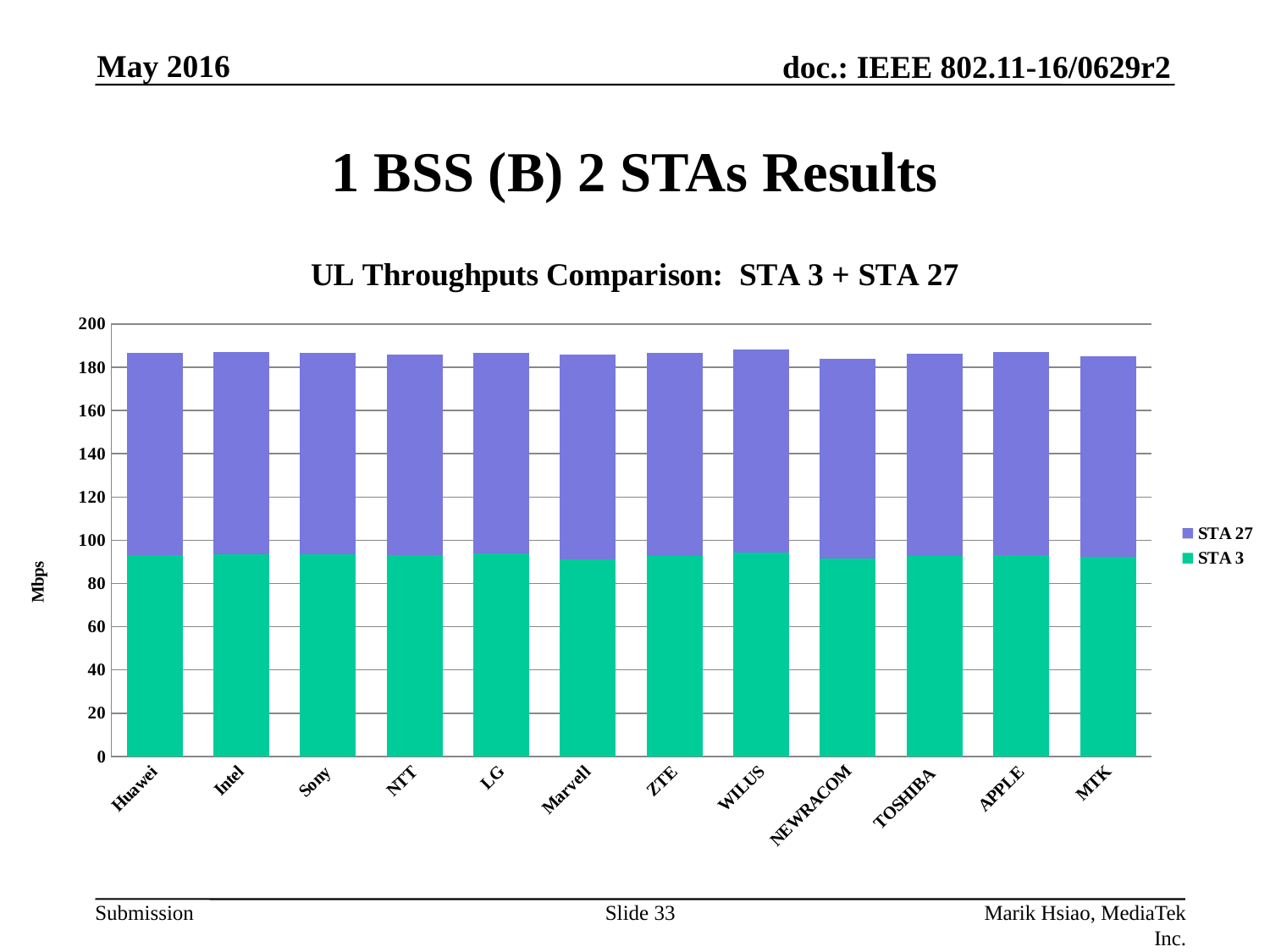
How many series does the legend list? 2 How many companies are shown along the x axis of the chart? 12 Is the total stacked value for NEWRACOM greater or less than 200? less Is the total stacked value for MTK greater or less than 160? greater What is the title of the chart? UL Throughputs Comparison: STA 3 + STA 27 Which company has the highest total stacked bar? WILUS What kind of chart is shown on the slide? stacked bar chart Is the STA 3 value for Marvell greater or less than 100? less What unit is shown on the y axis label? Mbps